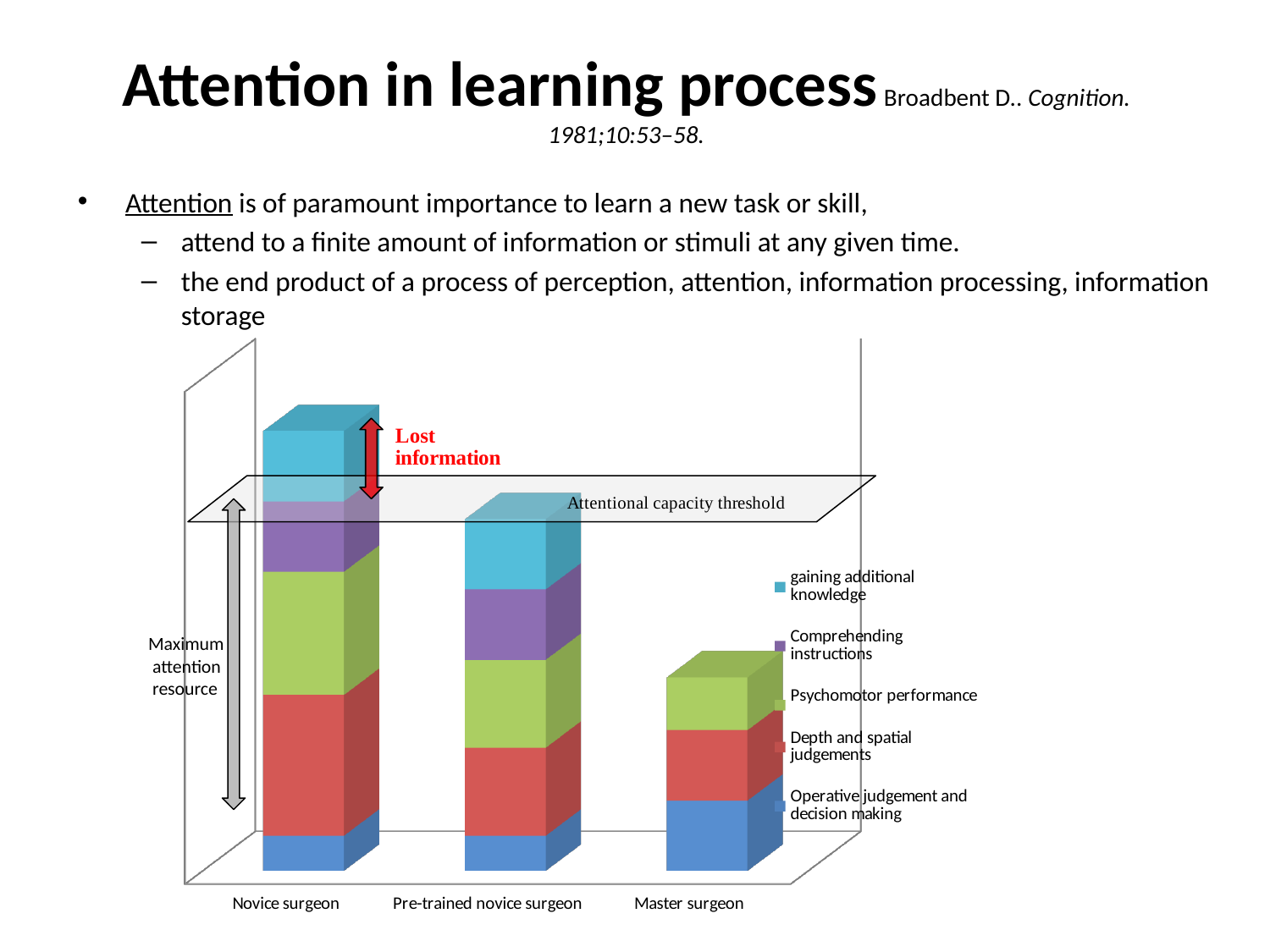
How many coloured segments are visible in the Master surgeon bar? 3 Which stacked bar is taller, Pre-trained novice surgeon or Master surgeon? Pre-trained novice surgeon Which stacked bar is taller, Novice surgeon or Master surgeon? Novice surgeon Which legend entry is shown at the bottom of the stacked bars (blue segment)? Operative judgement and decision making Do the stacked bar heights rise or fall from left to right across the categories? Fall Which category has the shortest stacked bar? Master surgeon How many categories are shown along the x axis of the chart? 3 Which category has the tallest stacked bar? Novice surgeon Which category's bar extends above the attentional capacity threshold plane? Novice surgeon What kind of chart is shown on the slide? Stacked bar chart How many series does the chart's legend list? 5